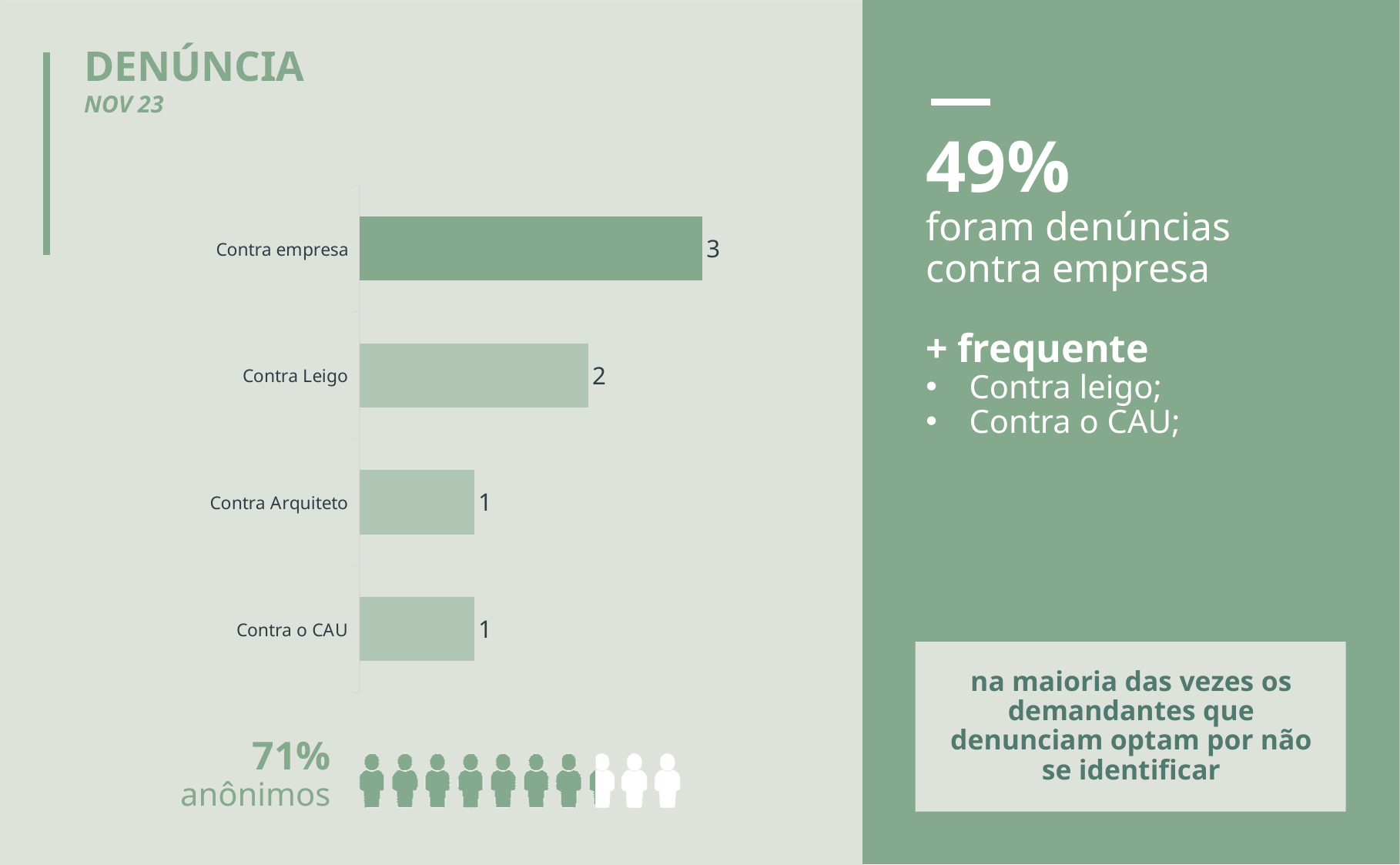
What is the difference between the values for Contra empresa and Contra Leigo? 1 Which category has the highest value? Contra empresa What is the value for Contra Arquiteto? 1 What kind of chart is shown on the slide? Bar chart How many categories are shown in the chart? 4 What is the total of all the values shown in the chart? 7 What is the value for Contra Leigo? 2 What is the value for Contra empresa? 3 What is the value for Contra o CAU? 1 Which category is listed at the top of the chart? Contra empresa Which is larger, the value for Contra Leigo or the value for Contra Arquiteto? Contra Leigo What is the difference between the values for Contra empresa and Contra o CAU? 2